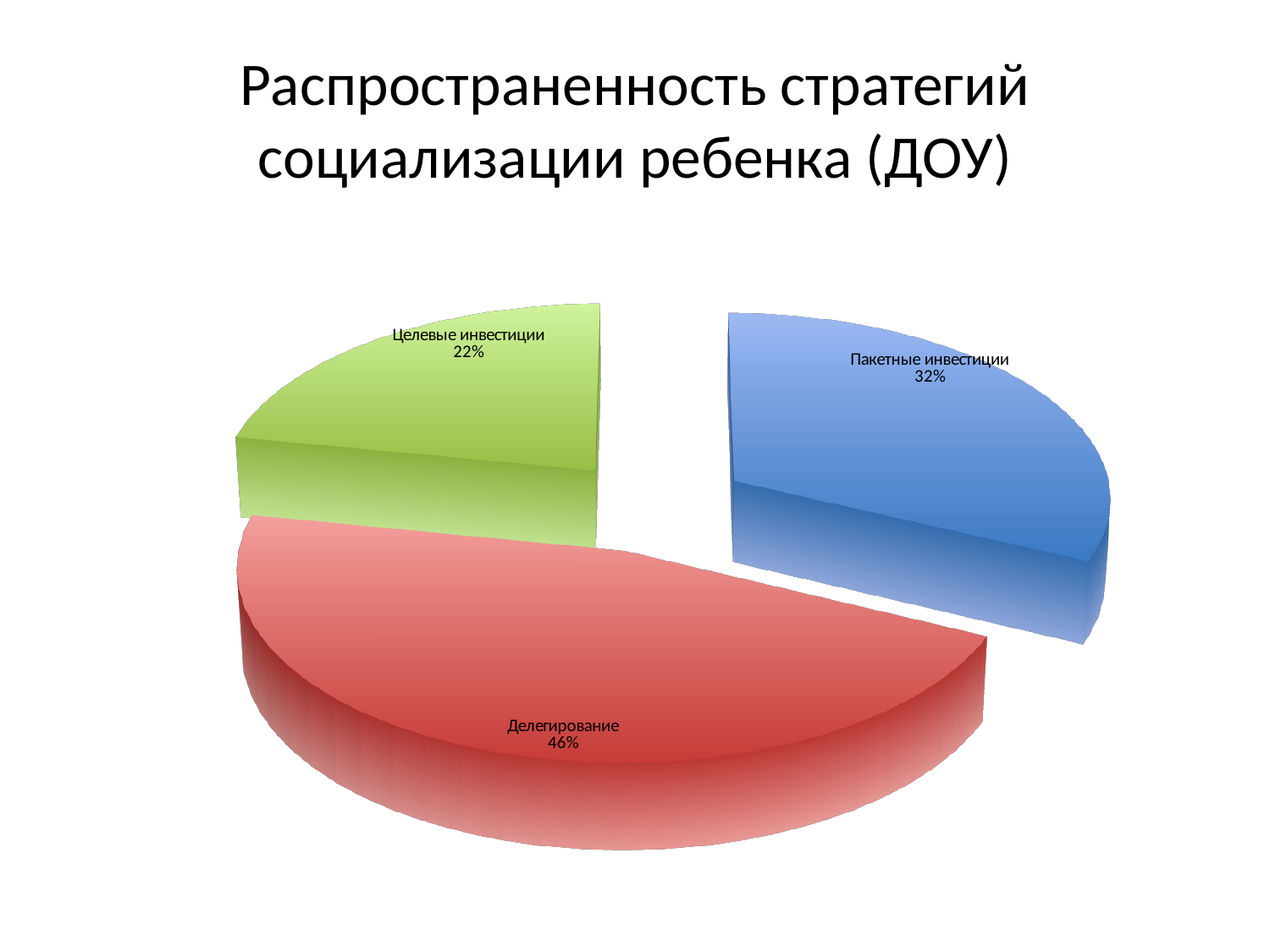
What kind of chart is shown on the slide? Pie chart What is the value shown for Целевые инвестиции? 22% Which is larger, Пакетные инвестиции or Целевые инвестиции? Пакетные инвестиции What is the difference in percentage points between Пакетные инвестиции and Целевые инвестиции? 10 How many categories are shown in the pie chart? 3 What is the title of the slide? Распространенность стратегий социализации ребенка (ДОУ) Which category has the largest slice of the pie? Делегирование What is the difference in percentage points between Делегирование and Пакетные инвестиции? 14 What share of the pie does Делегирование have? 46% What colour is the slice for Делегирование? Red What is the value shown for Пакетные инвестиции? 32% Which category has the smallest slice of the pie? Целевые инвестиции